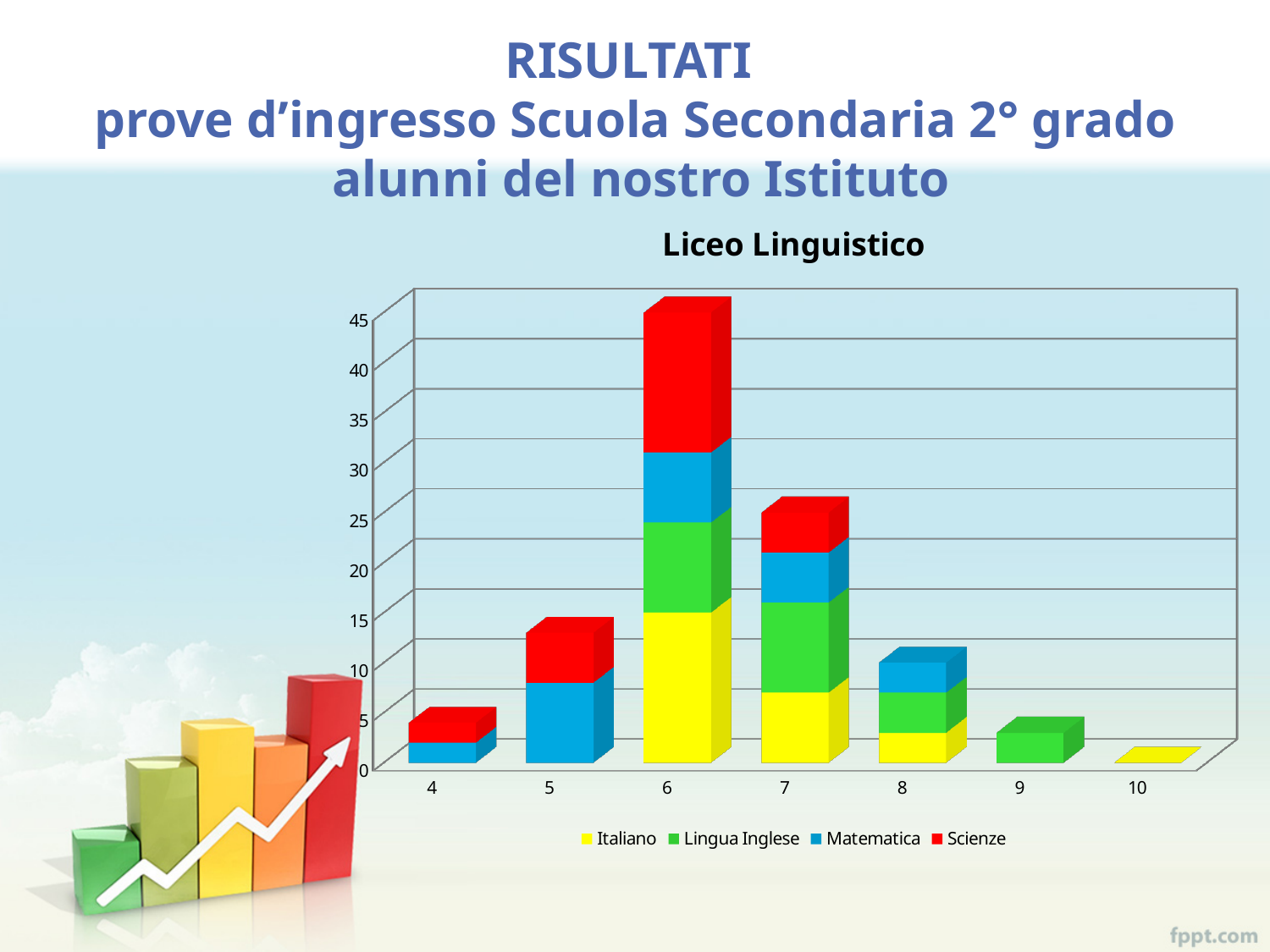
How many series does the legend list? 4 Which category has the highest stacked total? 6 Which colour represents the Scienze series in the legend? Red Is the stacked total for category 6 greater or less than 40? greater Is the stacked total for category 9 greater or less than 5? less Which category has the lowest stacked total? 10 Is the stacked total for category 7 greater or less than 20? greater What is the title of the chart? Liceo Linguistico What kind of chart is shown on the slide? Stacked bar chart Which has the larger stacked total, category 7 or category 8? 7 How many categories are shown on the x axis? 7